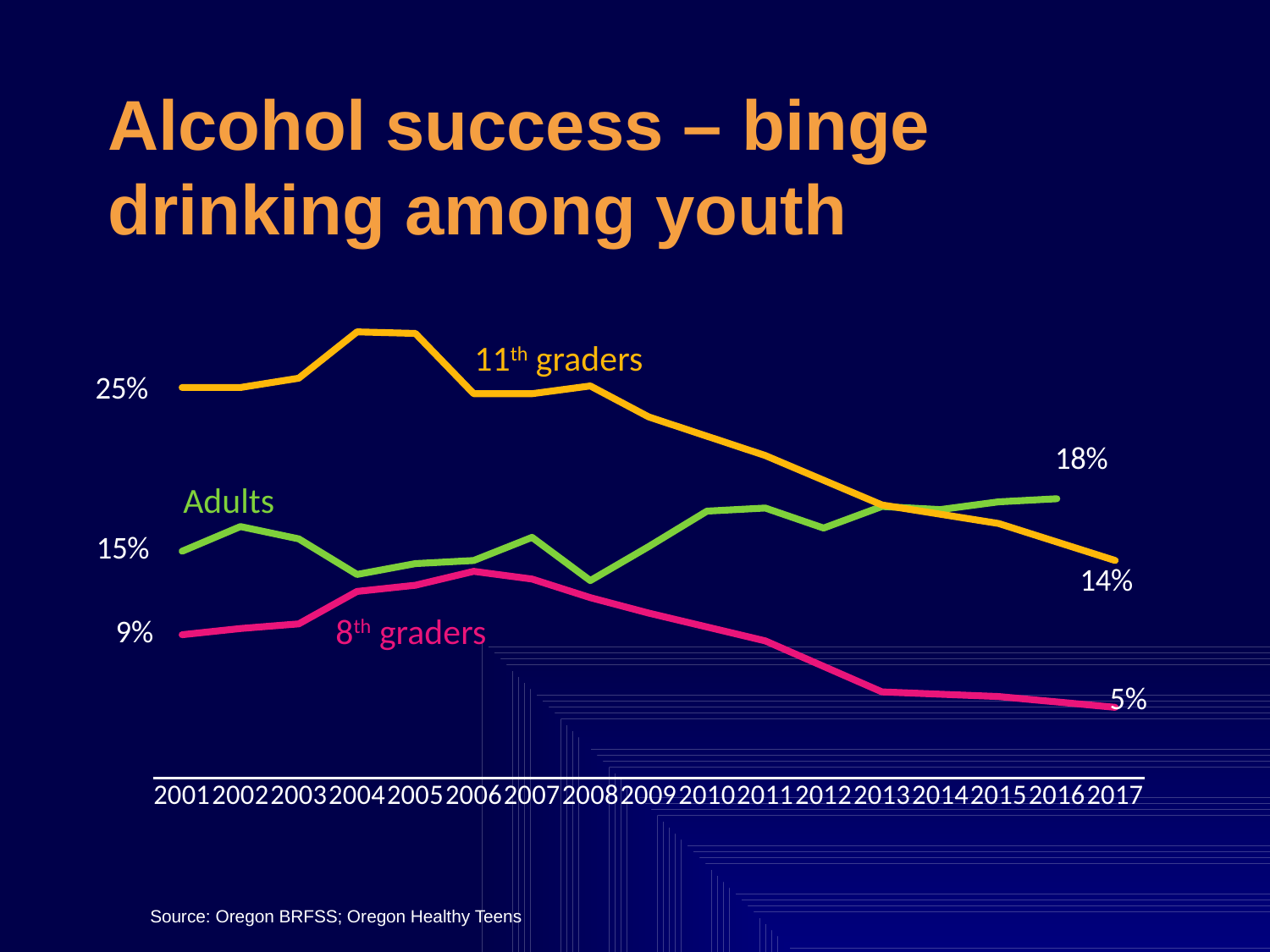
Does the 11th graders line rise or fall overall from 2001 to 2017? fall What is the difference between the 11th graders' rate and the 8th graders' rate in 2001? 16 percentage points What is the final labelled value for the 11th graders line? 14% What is the final labelled value for the Adults line? 18% How many years are shown on the x axis? 17 What is the final labelled value for the 8th graders line? 5% What was the binge drinking rate for Adults in 2001? 15% What was the binge drinking rate for 11th graders in 2001? 25% Which group had the lowest binge drinking rate in 2001? 8th graders Which group had the highest binge drinking rate in 2001? 11th graders What was the binge drinking rate for 8th graders in 2001? 9% What type of chart is shown on the slide? line chart